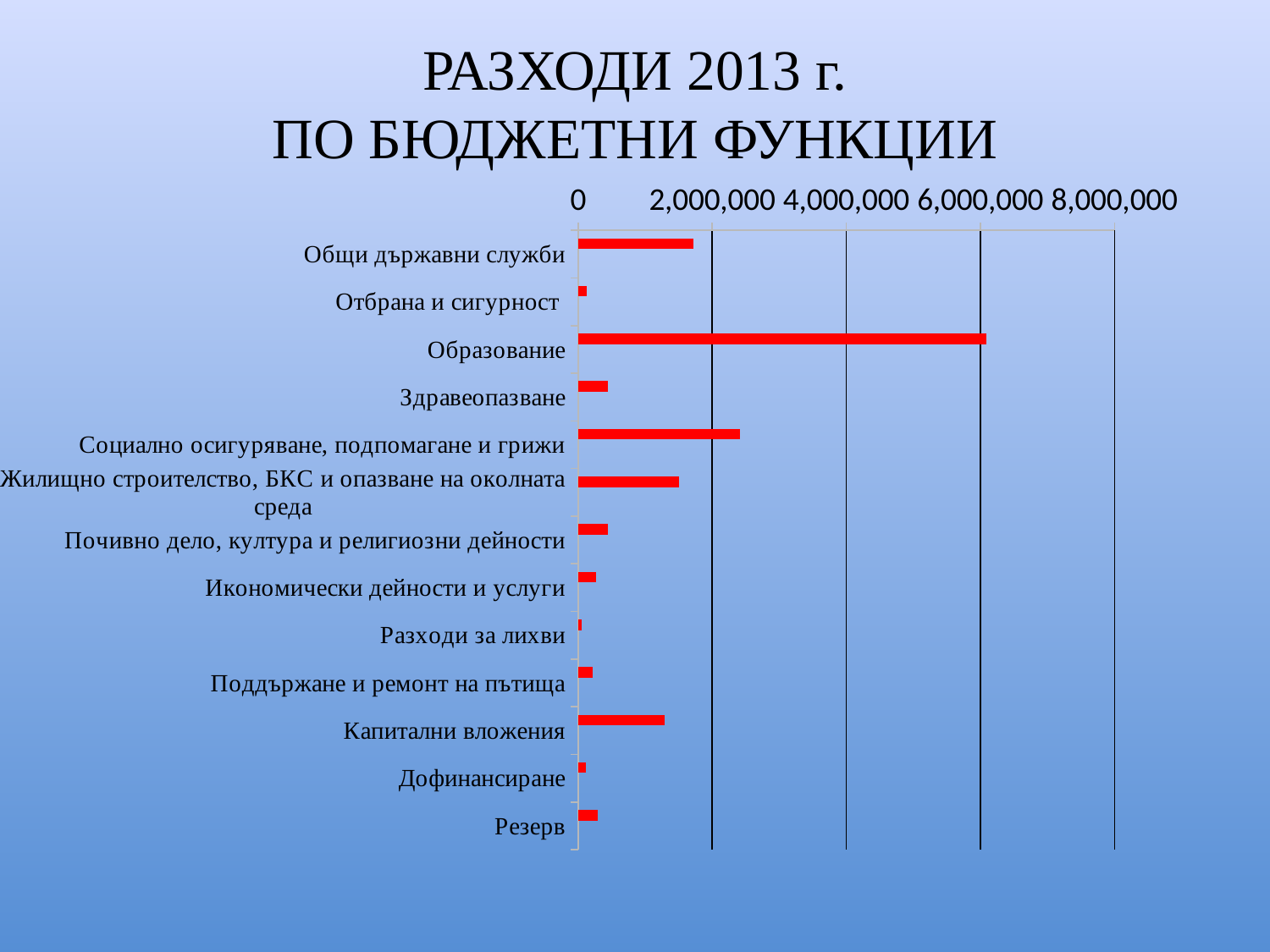
How many budget functions (categories) are shown in the chart? 13 Is the value for Общи държавни служби greater or less than 2,000,000? less Which is larger, the value for Социално осигуряване, подпомагане и грижи or the value for Жилищно строителство, БКС и опазване на околната среда? Социално осигуряване, подпомагане и грижи What is the title of the slide containing the chart? РАЗХОДИ 2013 г. ПО БЮДЖЕТНИ ФУНКЦИИ Is the value for Социално осигуряване, подпомагане и грижи greater or less than 2,000,000? greater Which budget function has the lowest expenditure in the chart? Разходи за лихви Which budget function has the highest expenditure in the chart? Образование What colour are the bars in the chart? red Which is larger, the value for Общи държавни служби or the value for Капитални вложения? Общи държавни служби Is the value for Капитални вложения greater or less than 2,000,000? less What kind of chart is shown on the slide? bar chart